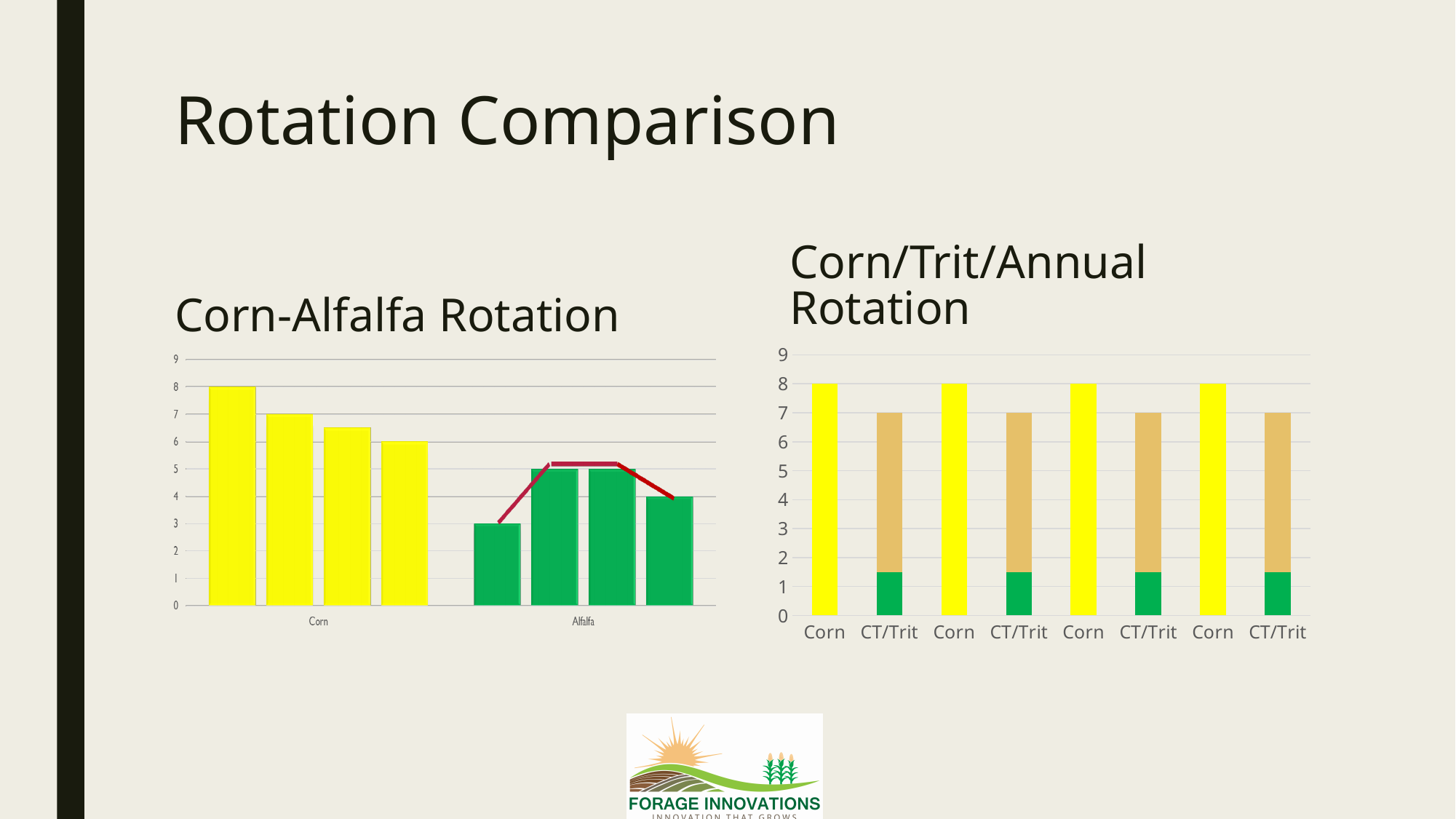
In the Corn/Trit/Annual Rotation chart, which is taller, a Corn bar or a CT/Trit bar? Corn In the Corn/Trit/Annual Rotation chart, how many categories are shown on the x axis? 8 In the Corn/Trit/Annual Rotation chart, what is the total height of each stacked CT/Trit bar? 7 In the Corn-Alfalfa Rotation chart, how many bars are plotted in total? 8 In the Corn/Trit/Annual Rotation chart, what value do the Corn bars reach? 8 In the Corn-Alfalfa Rotation chart, which group, Corn or Alfalfa, contains the tallest bar? Corn In the Corn-Alfalfa Rotation chart, do the Corn bars rise or fall from left to right? fall In the Corn-Alfalfa Rotation chart, what value does the tallest Corn bar reach? 8 In the Corn-Alfalfa Rotation chart, is the third Corn bar greater or less than 6? greater In the Corn/Trit/Annual Rotation chart, what colour are the Corn bars? yellow In the Corn-Alfalfa Rotation chart, what value does the first (leftmost) Alfalfa bar reach? 3 What type of chart is the Corn-Alfalfa Rotation chart? bar chart